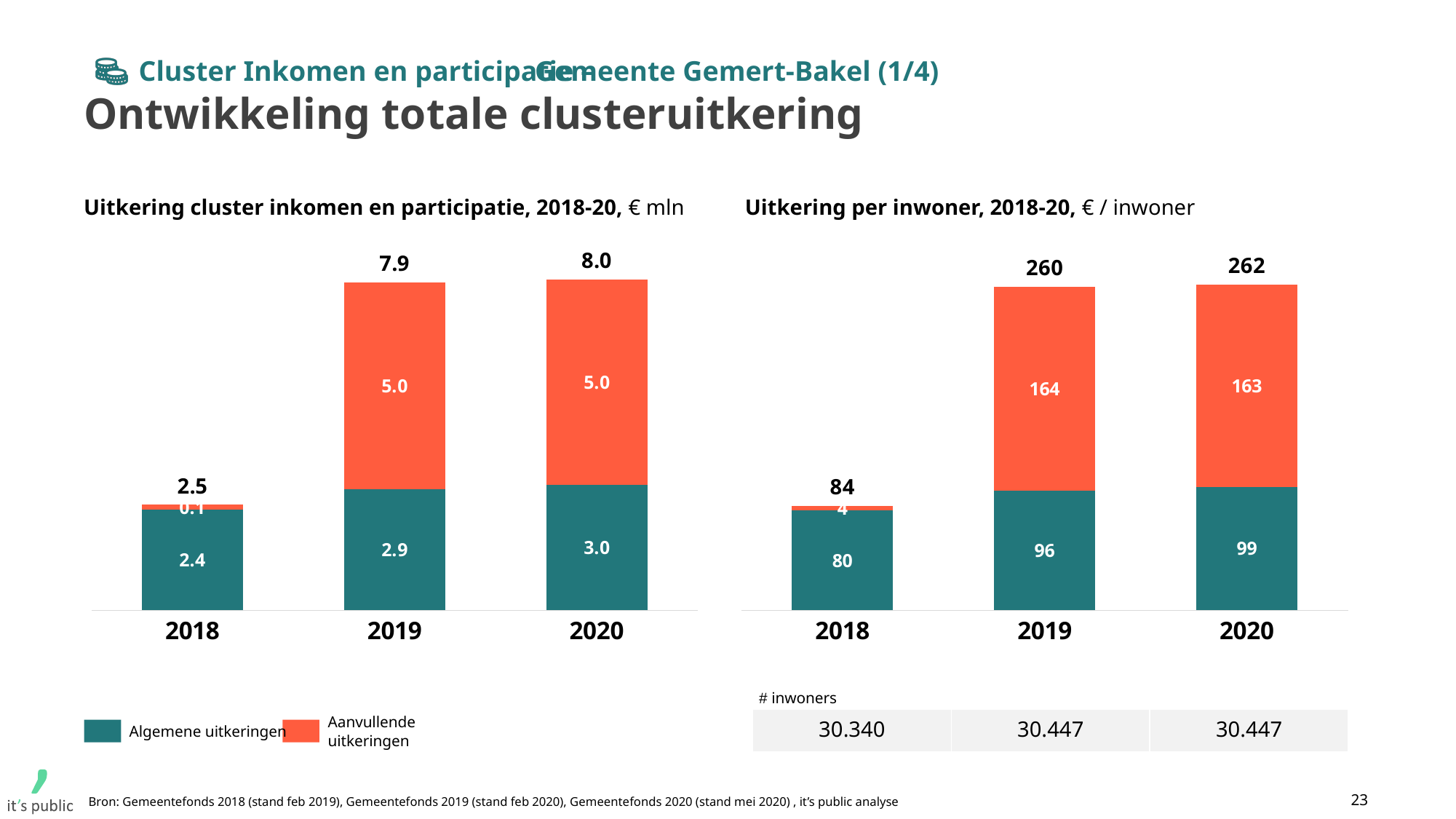
In the right chart (Uitkering per inwoner), which year has the highest total uitkering per inwoner? 2020 What type of chart is the right chart (Uitkering per inwoner)? Stacked bar chart In the left chart (Uitkering cluster inkomen en participatie), which year has the lowest total uitkering? 2018 In the right chart (Uitkering per inwoner), what is the difference between the Algemene uitkeringen in 2020 and in 2018? 19 In the right chart (Uitkering per inwoner), is the Aanvullende uitkeringen value larger in 2019 or in 2020? 2019 In the right chart (Uitkering per inwoner), what is the value of Aanvullende uitkeringen for 2020? 163 In the right chart (Uitkering per inwoner), what is the total of the stacked bar for 2019? 260 How many series does the legend list for the charts on this slide? 2 In the left chart (Uitkering cluster inkomen en participatie), what is the difference between the Aanvullende uitkeringen in 2019 and in 2018? 4.9 In the left chart (Uitkering cluster inkomen en participatie), what is the total of the stacked bar for 2020? 8.0 In the left chart (Uitkering cluster inkomen en participatie), what is the value of Algemene uitkeringen for 2019? 2.9 How many years are shown on the x axis of the left chart (Uitkering cluster inkomen en participatie)? 3